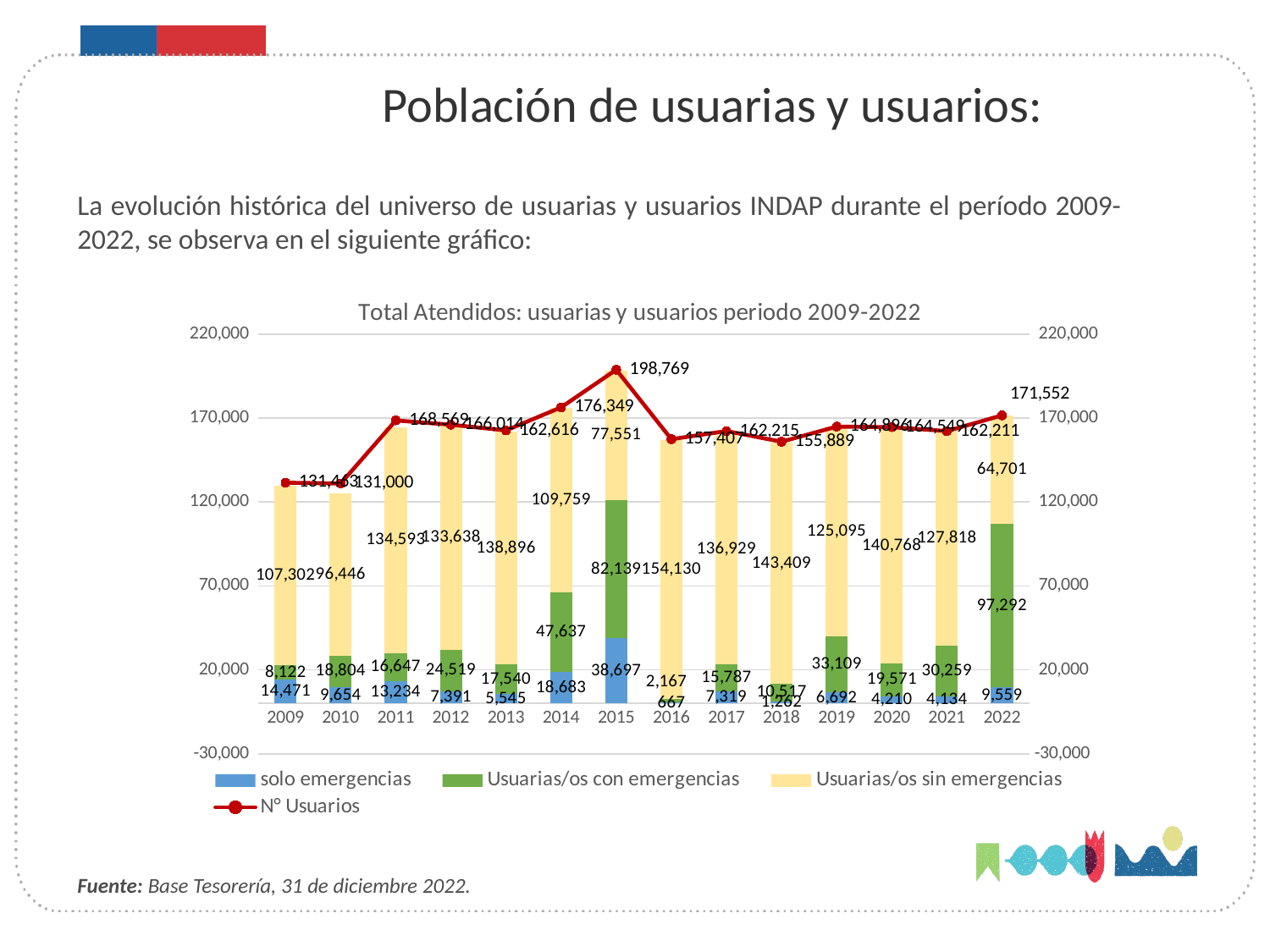
In which year is the Nº Usuarios line at its highest? 2015 What is the Nº Usuarios value for 2015? 198,769 Which year has the larger Usuarias/os con emergencias value, 2014 or 2019? 2014 How many years are shown on the x axis of the chart? 14 What kind of chart is shown on the slide? A stacked bar chart with a line What is the value of solo emergencias for 2014? 18,683 How many series does the chart legend list? 4 What is the value of Usuarias/os con emergencias for 2022? 97,292 What is the title of the chart? Total Atendidos: usuarias y usuarios periodo 2009-2022 In which year is the solo emergencias value the lowest? 2016 What is the value of Usuarias/os sin emergencias for 2016? 154,130 By how much did Nº Usuarios increase from 2021 to 2022? 9,341